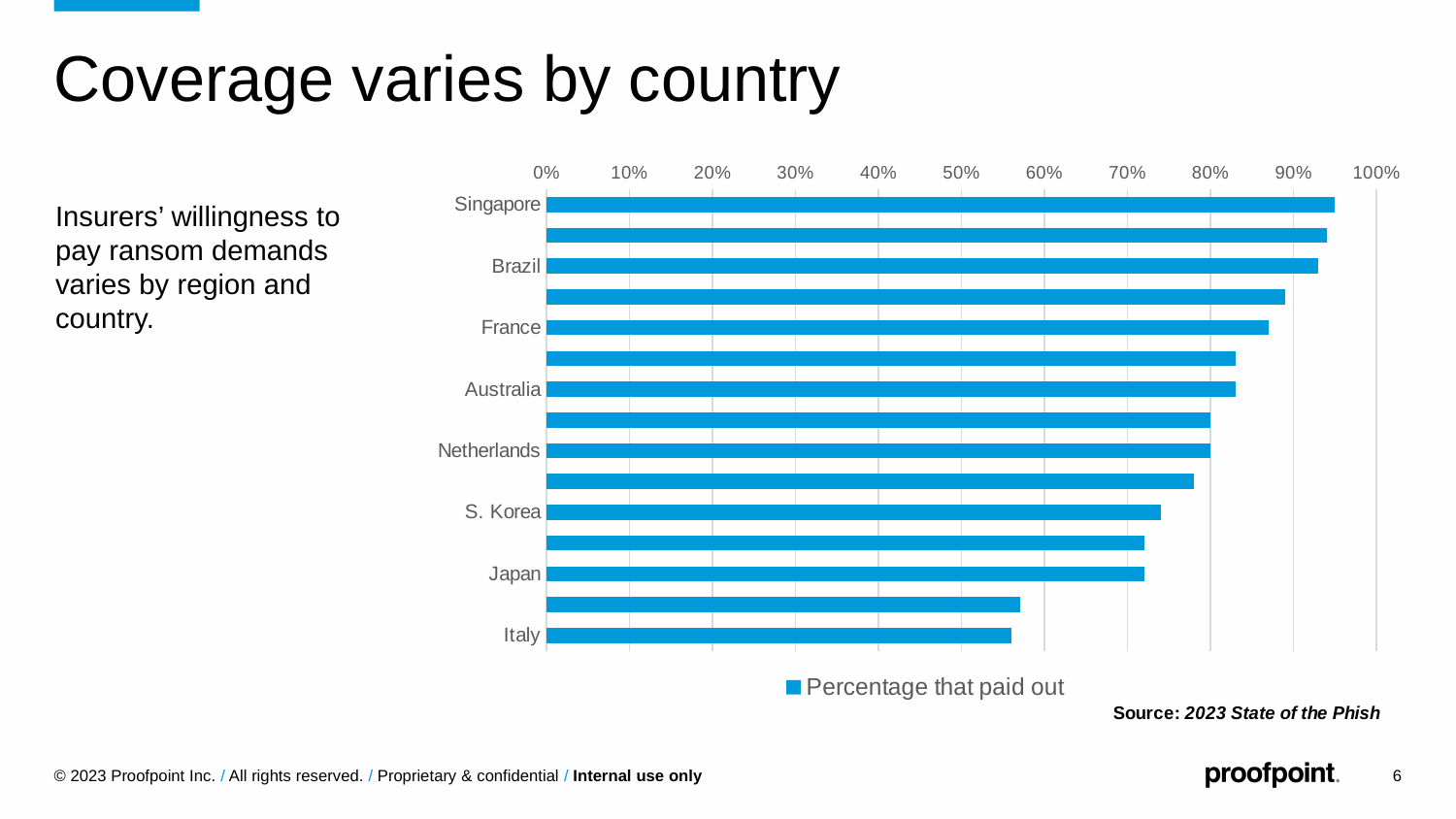
Is the value for S. Korea greater or less than 70%? greater What kind of chart is shown on the slide? bar chart Which labelled country has the lowest percentage that paid out? Italy How many bars are plotted in the chart? 15 Is the value for France greater or less than 80%? greater Which has a larger percentage that paid out, Brazil or Japan? Brazil Is the value for Japan greater or less than 80%? less What is the legend entry for the series in the chart? Percentage that paid out Which labelled country has the highest percentage that paid out? Singapore How many series does the legend list? 1